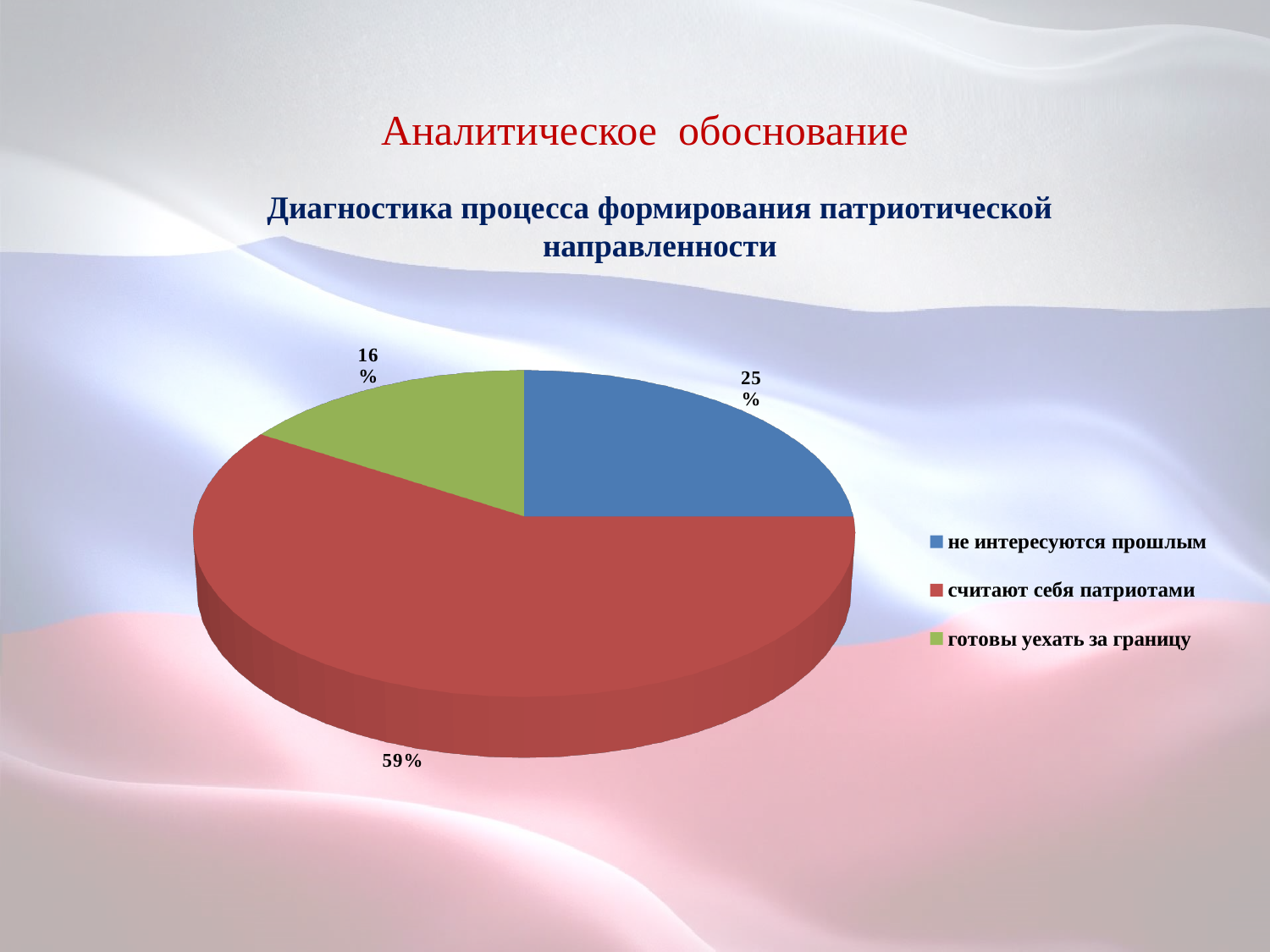
How many categories does the pie chart have? 3 Which category has the largest slice of the pie? считают себя патриотами What percentage of the pie is labelled for 'готовы уехать за границу'? 16% What is the difference in percentage points between 'не интересуются прошлым' and 'готовы уехать за границу'? 9 Which is larger: the slice for 'не интересуются прошлым' or the slice for 'готовы уехать за границу'? не интересуются прошлым What is the difference in percentage points between 'считают себя патриотами' and 'не интересуются прошлым'? 34 What is the title of the chart? Диагностика процесса формирования патриотической направленности Which category has the smallest slice of the pie? готовы уехать за границу What colour is the slice for 'считают себя патриотами'? red What percentage of the pie is labelled for 'не интересуются прошлым'? 25% What kind of chart is shown on the slide? pie chart What percentage of the pie is labelled for 'считают себя патриотами'? 59%